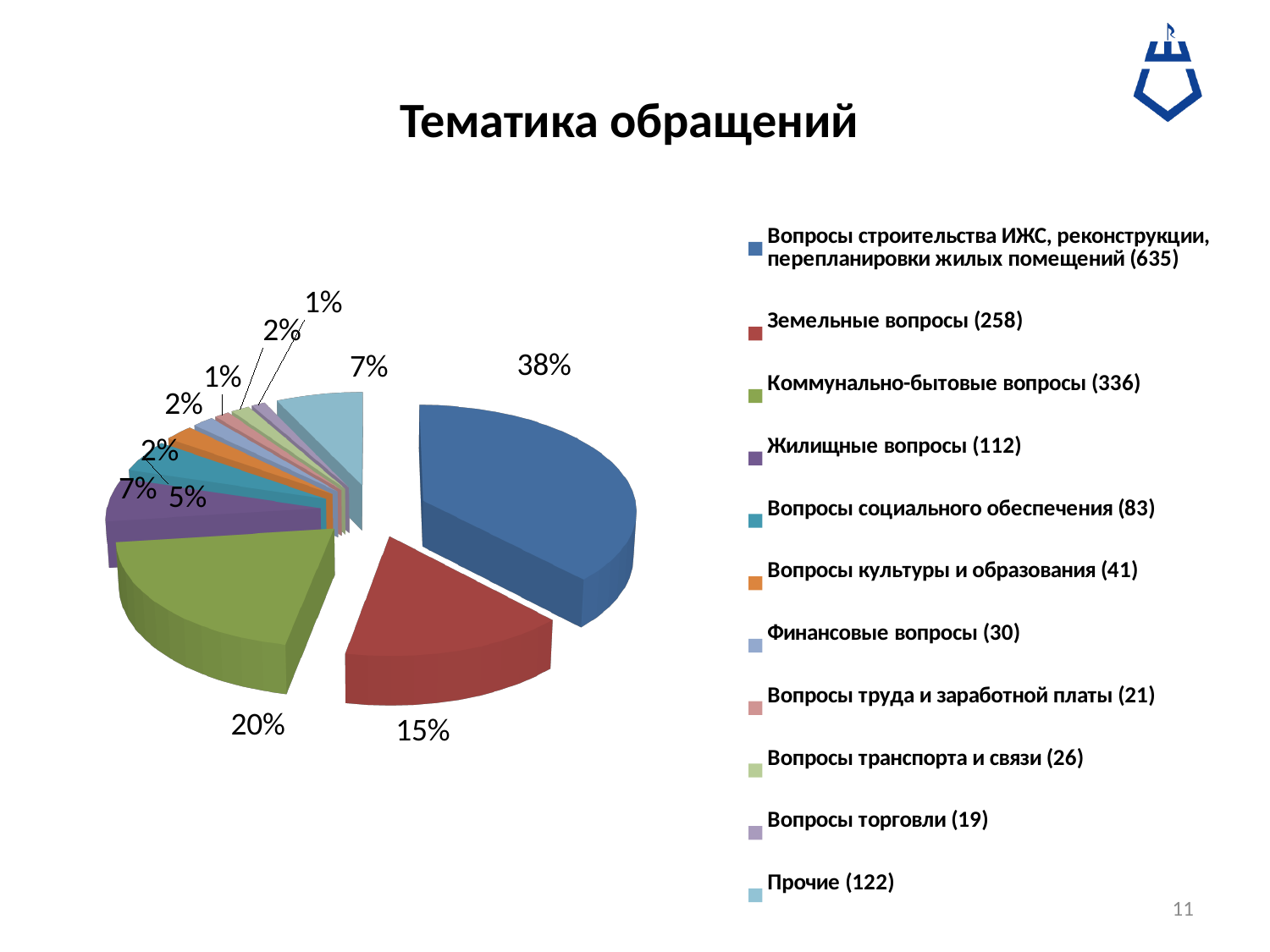
Which has more appeals: 'Вопросы социального обеспечения' or 'Вопросы культуры и образования'? Вопросы социального обеспечения Which category has the smallest number of appeals according to the legend? Вопросы торговли (19) What share of the pie does the category 'Вопросы строительства ИЖС, реконструкции, перепланировки жилых помещений' take? 38% How many appeals are listed in the legend for 'Прочие'? 122 What share of the pie does 'Коммунально-бытовые вопросы' take? 20% What is the difference between the number of appeals for 'Коммунально-бытовые вопросы' and 'Земельные вопросы'? 78 What type of chart is shown on the slide? pie chart What share of the pie does 'Земельные вопросы' take? 15% How many categories does the pie chart's legend list? 11 Which category has the largest slice of the pie? Вопросы строительства ИЖС, реконструкции, перепланировки жилых помещений What is the title of the chart on the slide? Тематика обращений How many appeals are listed in the legend for 'Жилищные вопросы'? 112